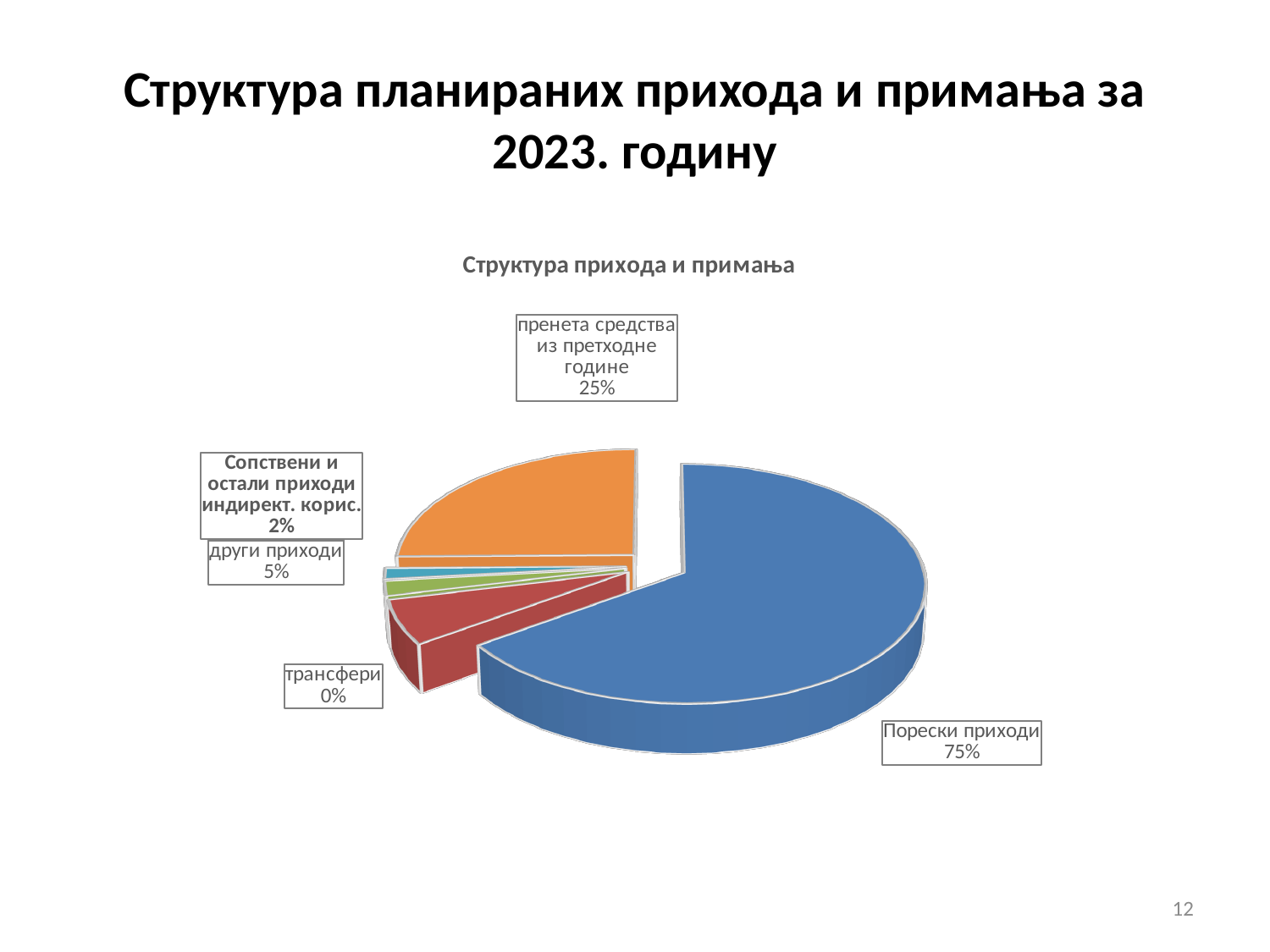
What colour is the slice for Порески приходи? blue Which category has the smallest labelled share? трансфери What is the title of the chart? Структура прихода и примања What kind of chart is shown on the slide? pie chart What percentage is labelled for Сопствени и остали приходи индирект. корис.? 2% Which is larger, the share for други приходи or the share for Сопствени и остали приходи индирект. корис.? други приходи How many labelled slices does the pie chart have? 5 What percentage is labelled for други приходи? 5% What share of the pie is labelled for Порески приходи? 75% What percentage is labelled for трансфери? 0% What share is shown for пренета средства из претходне године? 25% Which category has the largest slice of the pie? Порески приходи